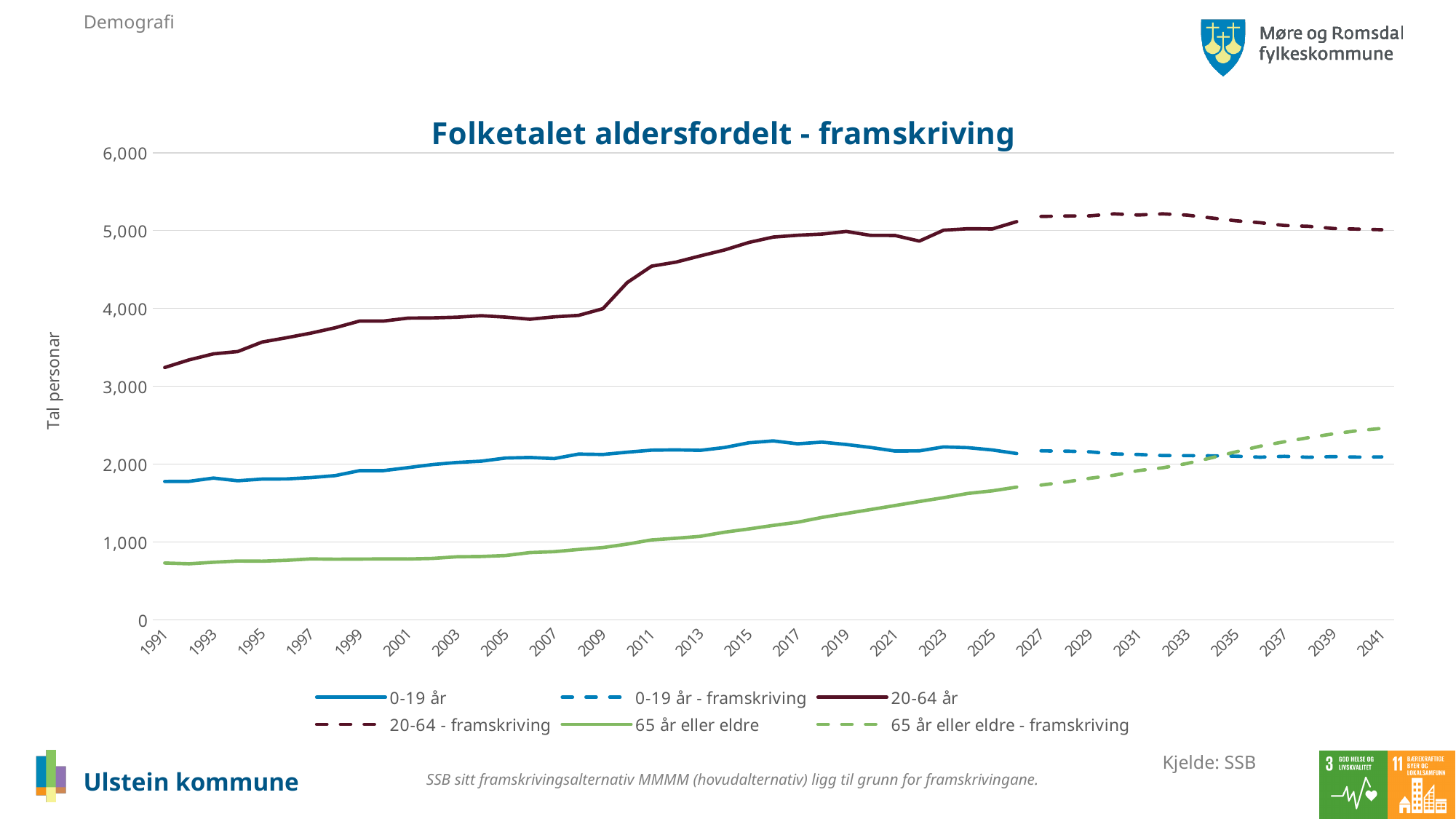
Is the value for 20-64 - framskriving in 2041 greater or less than 4,000? greater What is the title of the chart? Folketalet aldersfordelt - framskriving In 2011, which is larger: 0-19 år or 65 år eller eldre? 0-19 år Is the value for 65 år eller eldre in 1991 greater or less than 1,000? less Which series has the highest value in 2025? 20-64 år Is the value for 65 år eller eldre - framskriving in 2041 greater or less than 2,000? greater Which series has the lowest value in 1991? 65 år eller eldre What source is cited for the chart data? SSB How many series does the legend list? 6 Does the 65 år eller eldre series rise or fall from 1991 to 2025? rise What kind of chart is shown on the slide? line chart